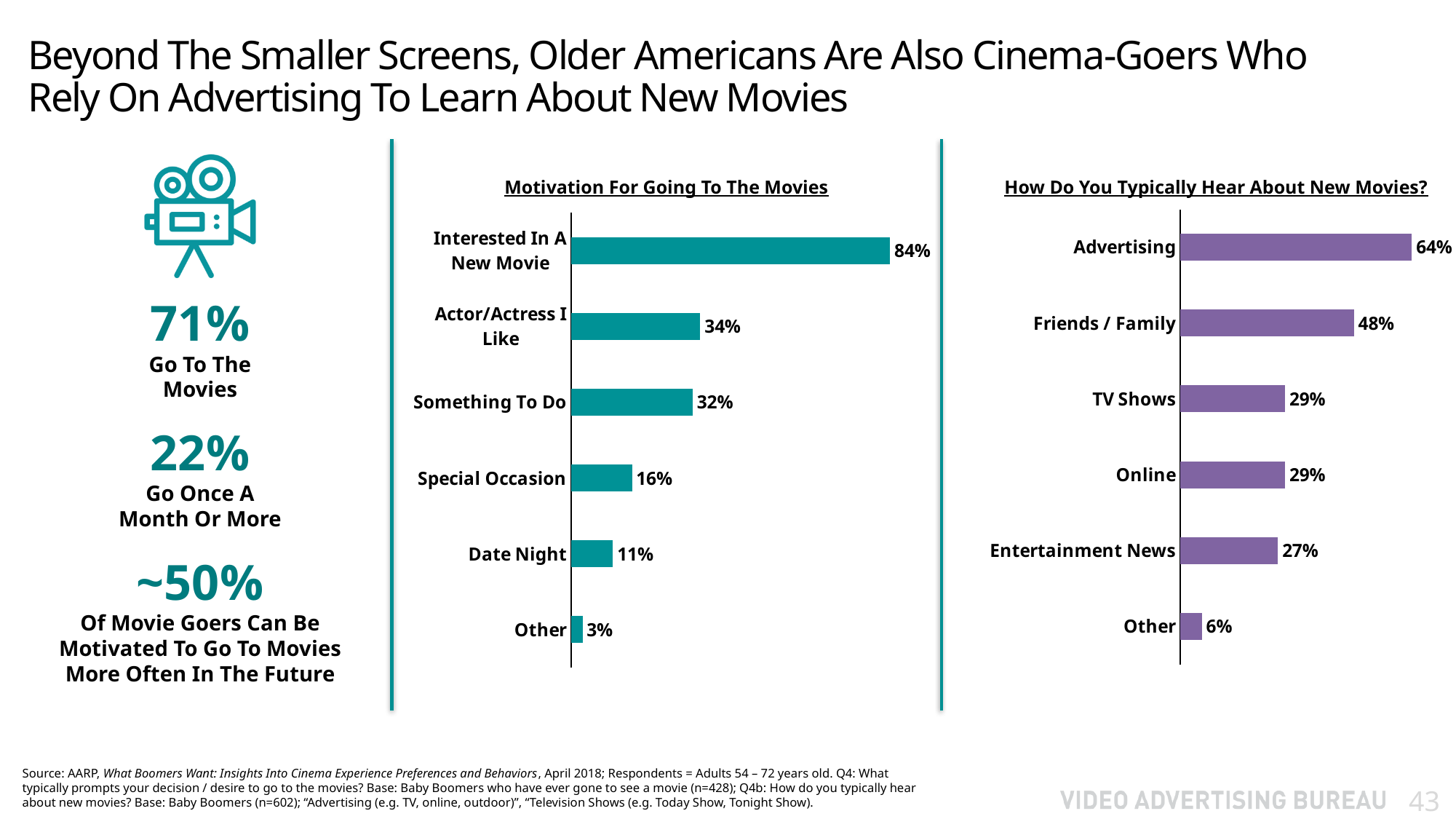
In the 'Motivation For Going To The Movies' chart, what is the value for 'Something To Do'? 32% How many categories are shown in the 'Motivation For Going To The Movies' chart? 6 In the 'Motivation For Going To The Movies' chart, which is larger: 'Date Night' or 'Special Occasion'? Special Occasion How many categories are shown in the 'How Do You Typically Hear About New Movies?' chart? 6 In the 'How Do You Typically Hear About New Movies?' chart, which is larger: 'Friends / Family' or 'TV Shows'? Friends / Family In the 'How Do You Typically Hear About New Movies?' chart, what is the value for 'Friends / Family'? 48% In the 'How Do You Typically Hear About New Movies?' chart, what is the difference between 'Advertising' and 'Entertainment News'? 37% What colour are the bars in the 'Motivation For Going To The Movies' chart? Teal In the 'Motivation For Going To The Movies' chart, which category has the highest value? Interested In A New Movie In the 'Motivation For Going To The Movies' chart, what is the difference between 'Actor/Actress I Like' and 'Special Occasion'? 18% What type of chart is the 'How Do You Typically Hear About New Movies?' chart? Bar chart In the 'How Do You Typically Hear About New Movies?' chart, which category has the lowest value? Other